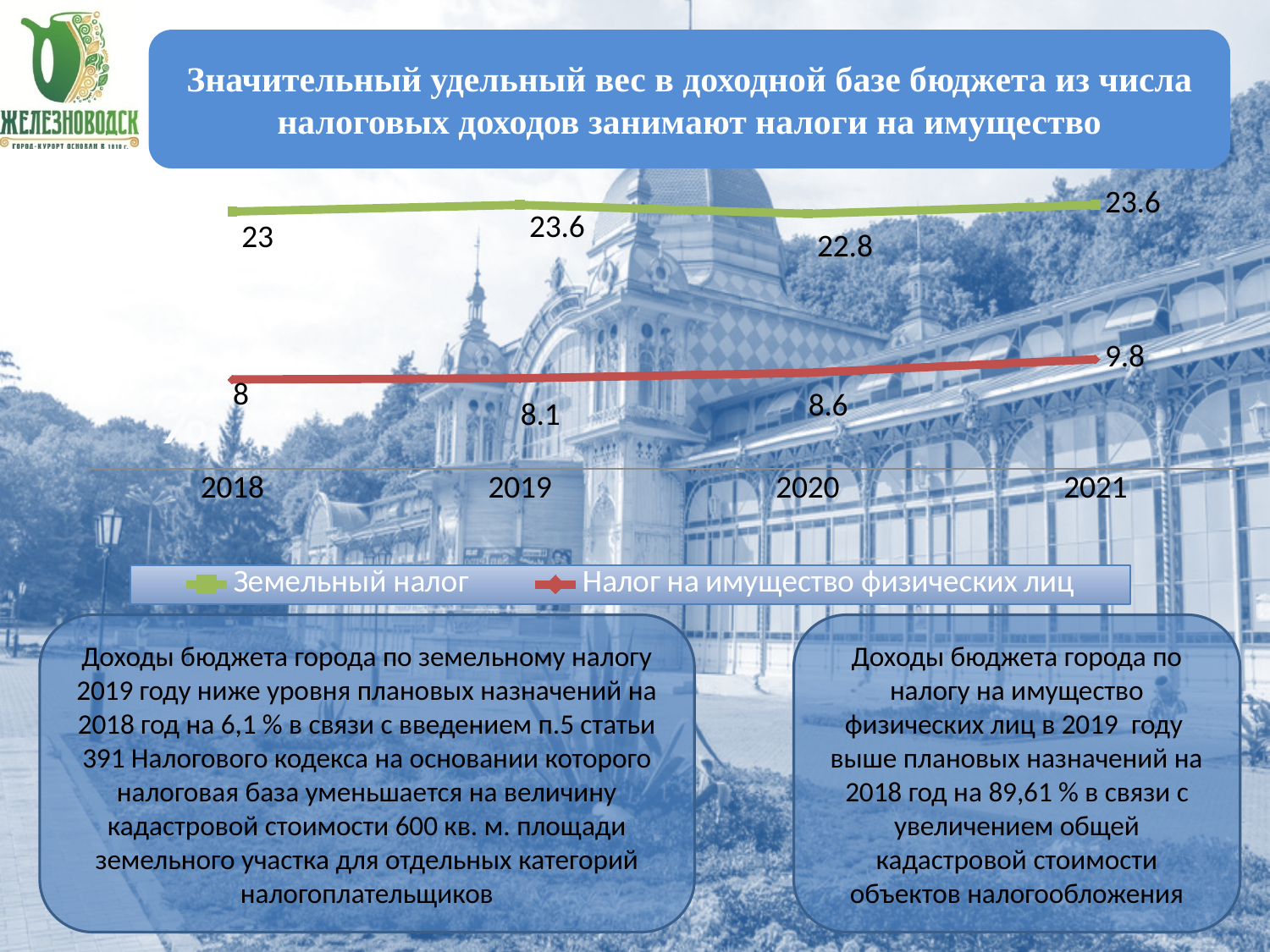
What is the value of Налог на имущество физических лиц in 2019? 8.1 In which year is Налог на имущество физических лиц highest? 2021 What kind of chart is shown on the slide? Line chart Which is larger in 2020: Земельный налог or Налог на имущество физических лиц? Земельный налог What is the value of Земельный налог in 2018? 23 In which year is Земельный налог lowest? 2020 What is the value of Налог на имущество физических лиц in 2021? 9.8 What is the value of Земельный налог in 2020? 22.8 By how much did Налог на имущество физических лиц increase from 2018 to 2021? 1.8 How many series does the legend list? 2 What is the difference between Земельный налог and Налог на имущество физических лиц in 2021? 13.8 How many years are shown on the x axis? 4